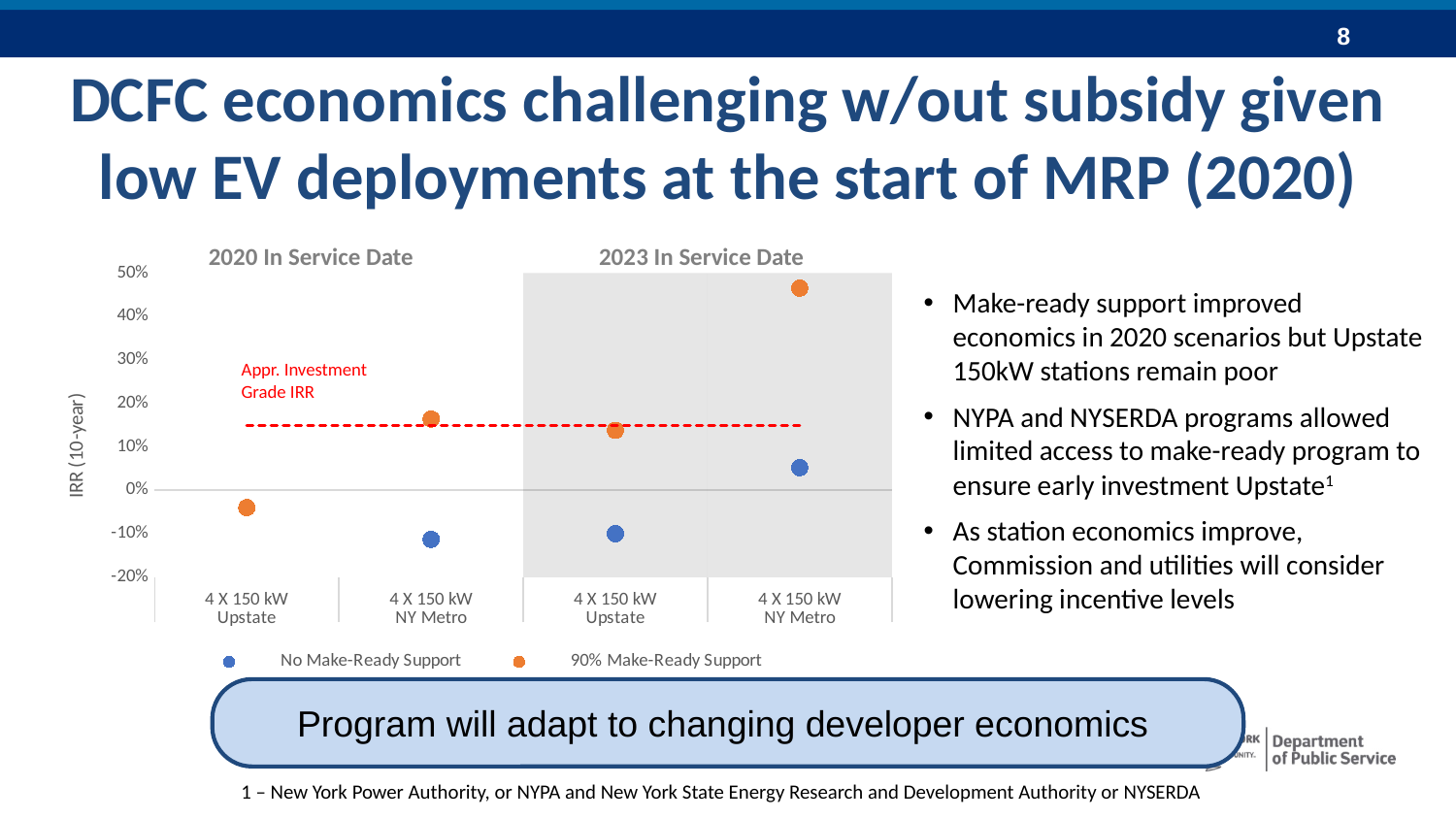
Is the No Make-Ready Support IRR for 4 X 150 kW NY Metro with a 2023 In Service Date greater or less than 0%? greater Is the 90% Make-Ready Support IRR for 4 X 150 kW Upstate with a 2020 In Service Date greater or less than 0%? less Which scenario has the highest IRR for the 90% Make-Ready Support series? 4 X 150 kW NY Metro (2023 In Service Date) Is the No Make-Ready Support IRR for 4 X 150 kW NY Metro with a 2020 In Service Date greater or less than 0%? less How many series does the chart legend list? 2 For 4 X 150 kW NY Metro with a 2023 In Service Date, which series has the higher IRR: No Make-Ready Support or 90% Make-Ready Support? 90% Make-Ready Support What is the label on the vertical axis of the chart? IRR (10-year) Which scenario has the highest IRR for the No Make-Ready Support series? 4 X 150 kW NY Metro (2023 In Service Date) What are the two series named in the chart legend? No Make-Ready Support and 90% Make-Ready Support How many station scenarios (categories) are plotted along the x axis of the chart? 4 Which scenario has the lowest IRR for the 90% Make-Ready Support series? 4 X 150 kW Upstate (2020 In Service Date)